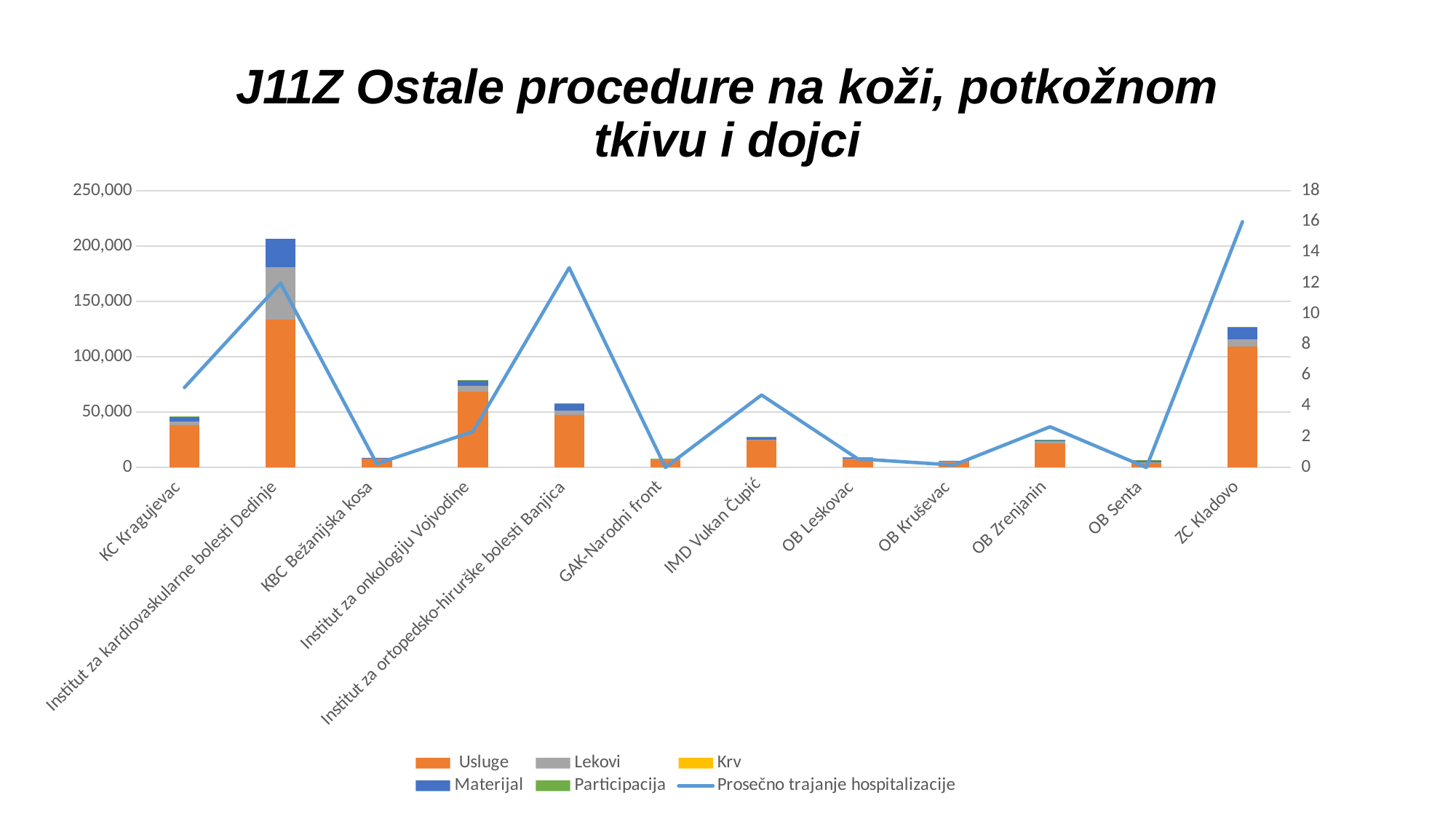
Which has the higher Prosečno trajanje hospitalizacije value, ZC Kladovo or Institut za ortopedsko-hirurške bolesti Banjica? ZC Kladovo How many institutions (categories) are shown on the x axis? 12 Is the Prosečno trajanje hospitalizacije value for ZC Kladovo greater or less than 14? greater Which institution has the tallest stacked bar? Institut za kardiovaskularne bolesti Dedinje Is the Prosečno trajanje hospitalizacije value for IMD Vukan Čupić greater or less than 6? less Is the total stacked bar for ZC Kladovo greater or less than 100,000? greater Which institution has the highest value on the Prosečno trajanje hospitalizacije line? ZC Kladovo How many series does the legend list? 6 What is the title of the chart? J11Z Ostale procedure na koži, potkožnom tkivu i dojci Which series is plotted as a line rather than as bars? Prosečno trajanje hospitalizacije Which has the taller stacked bar, Institut za onkologiju Vojvodine or Institut za ortopedsko-hirurške bolesti Banjica? Institut za onkologiju Vojvodine